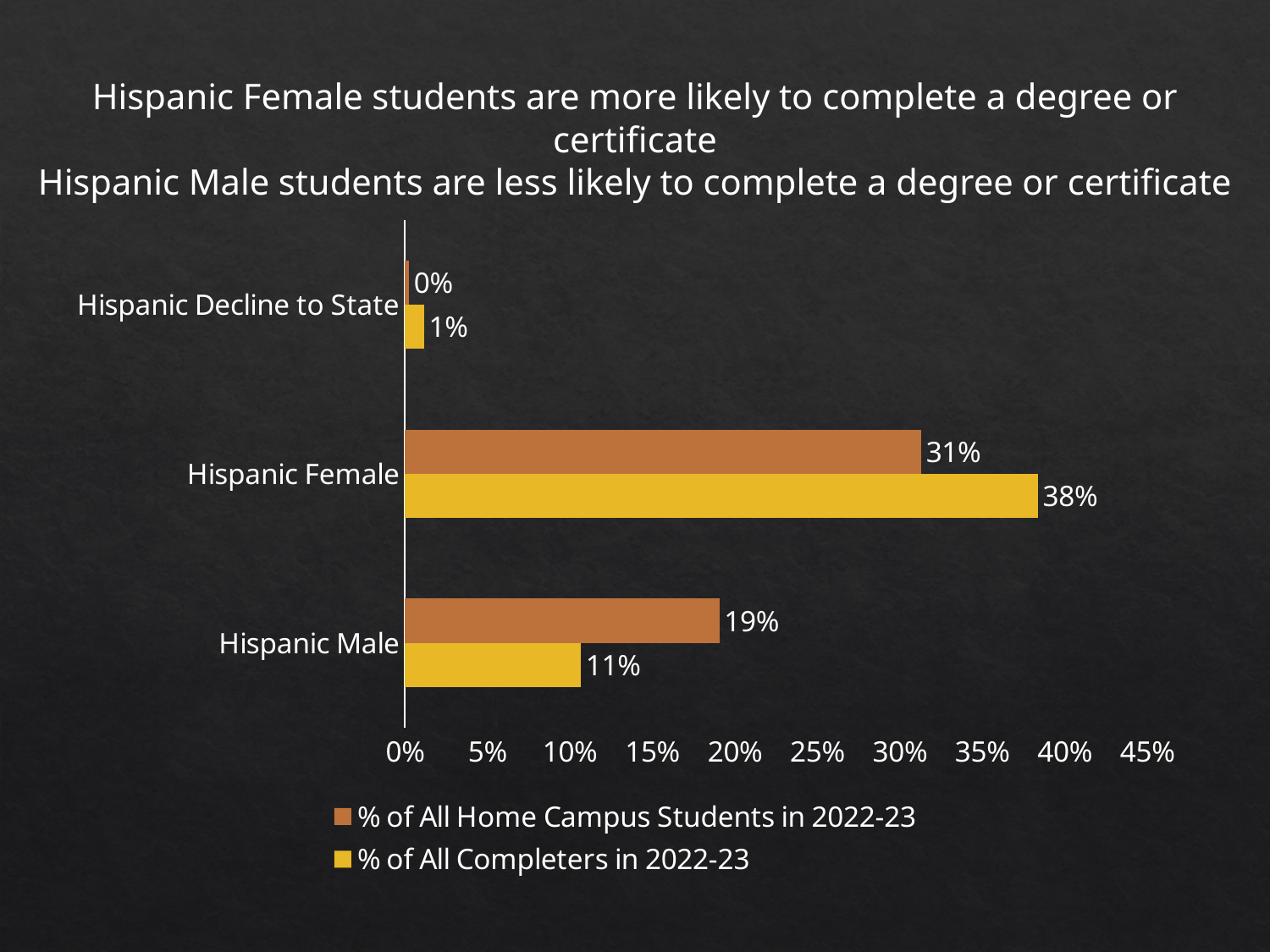
How many series does the legend list? 2 Which category has the highest % of All Completers in 2022-23? Hispanic Female What kind of chart is shown on the slide? Bar chart How many categories are shown on the chart? 3 What colour are the bars for % of All Completers in 2022-23? Yellow For Hispanic Male, which is larger: the % of All Home Campus Students in 2022-23 or the % of All Completers in 2022-23? % of All Home Campus Students in 2022-23 What is the % of All Completers in 2022-23 for Hispanic Decline to State? 1% What is the % of All Home Campus Students in 2022-23 for Hispanic Female? 31% What is the % of All Completers in 2022-23 for Hispanic Female? 38% Which category has the lowest % of All Home Campus Students in 2022-23? Hispanic Decline to State What is the % of All Home Campus Students in 2022-23 for Hispanic Male? 19% What is the difference between the % of All Completers in 2022-23 and the % of All Home Campus Students in 2022-23 for Hispanic Female? 7%